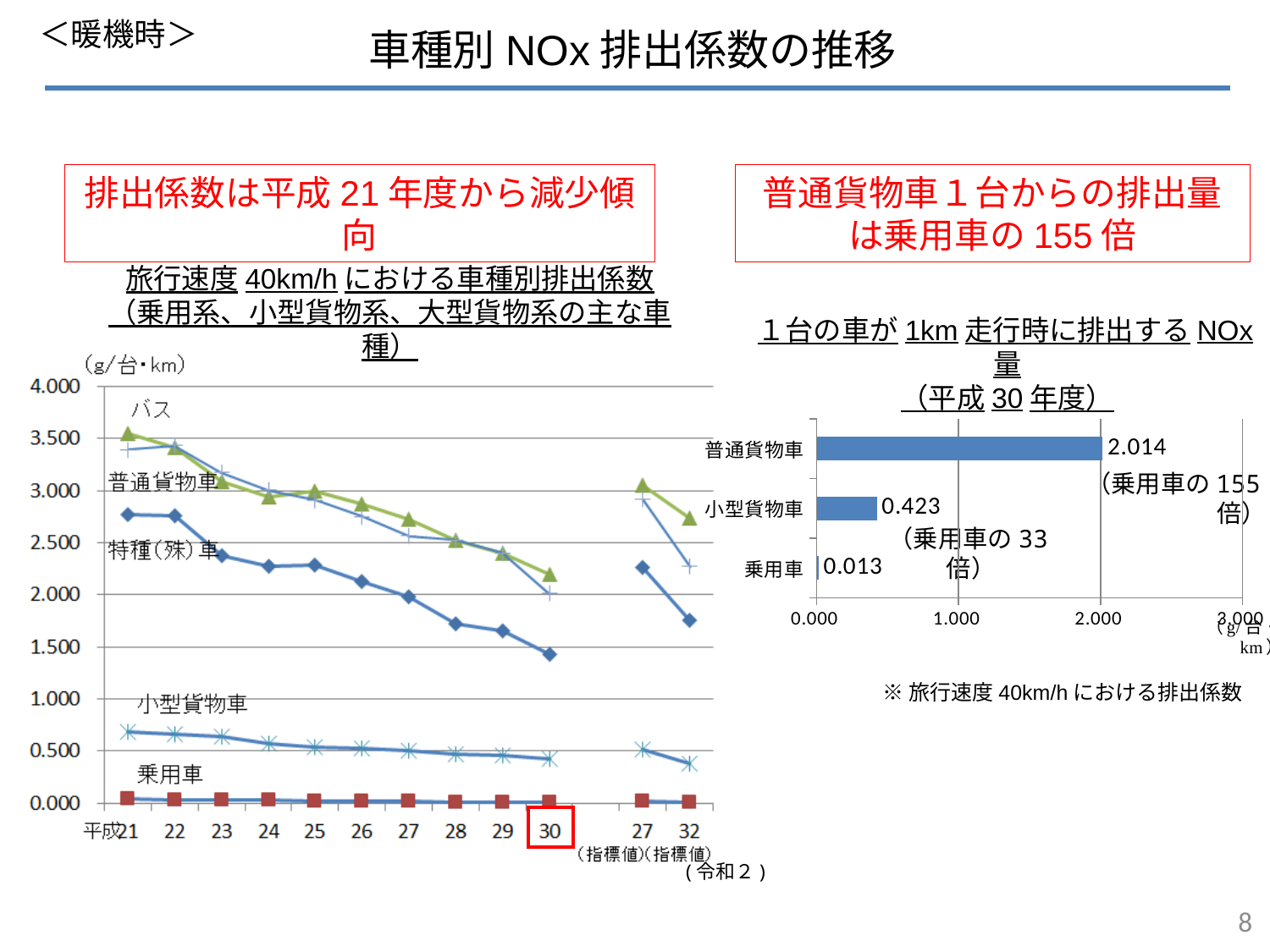
In the right-hand bar chart, which vehicle type has the lowest NOx emission? 乗用車 What kind of chart is the right-hand chart on the slide? Bar chart In the right-hand bar chart, what is the value for 小型貨物車? 0.423 In the right-hand bar chart, what is the difference between the values for 普通貨物車 and 小型貨物車? 1.591 In the left-hand line chart, is the value for バス in 平成21 greater or less than 3.000? greater In the left-hand line chart, do the emission factors for 普通貨物車 rise or fall from 平成21 to 平成30? Fall In the left-hand line chart, how many vehicle types are labeled? 5 In the right-hand bar chart, how many vehicle categories are shown? 3 What kind of chart is the left-hand chart (旅行速度40km/hにおける車種別排出係数)? Line chart In the right-hand bar chart (1台の車が1km走行時に排出するNOx量), what is the value for 普通貨物車? 2.014 In the right-hand bar chart, what is the value for 乗用車? 0.013 In the right-hand bar chart, which vehicle type has the highest NOx emission? 普通貨物車